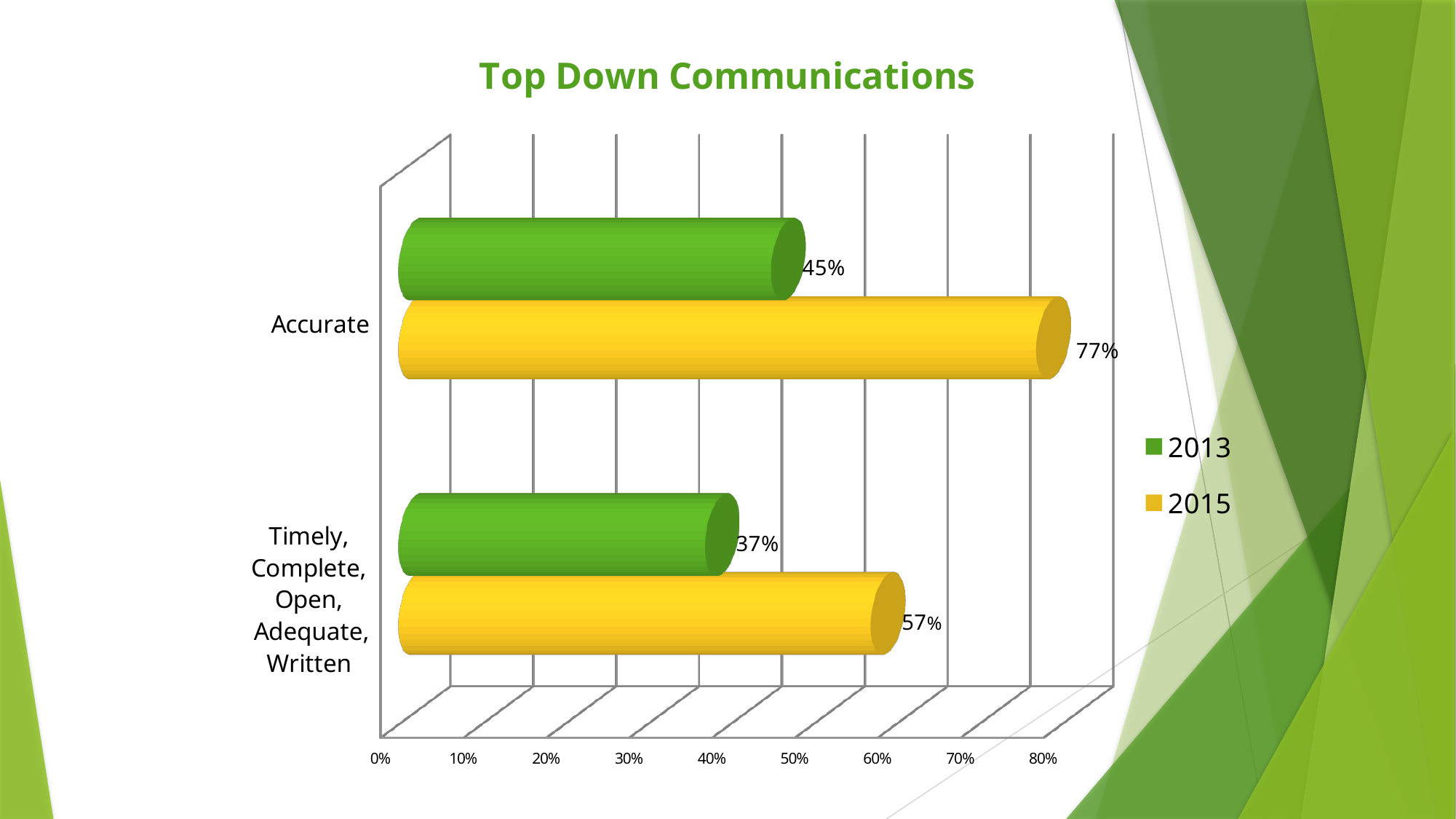
What is the difference between the 2015 and 2013 values for Accurate? 32% Which category has the highest 2015 value? Accurate What is the 2013 value for Timely, Complete, Open, Adequate, Written? 37% Which is larger for Accurate, the 2013 value or the 2015 value? 2015 Which category has the lowest 2013 value? Timely, Complete, Open, Adequate, Written What is the 2015 value for Timely, Complete, Open, Adequate, Written? 57% What is the 2015 value for Accurate? 77% How many categories are shown on the chart? 2 What is the difference between the 2015 and 2013 values for Timely, Complete, Open, Adequate, Written? 20% How many series does the legend list? 2 What is the 2013 value for Accurate? 45% What kind of chart is shown on the slide? Bar chart